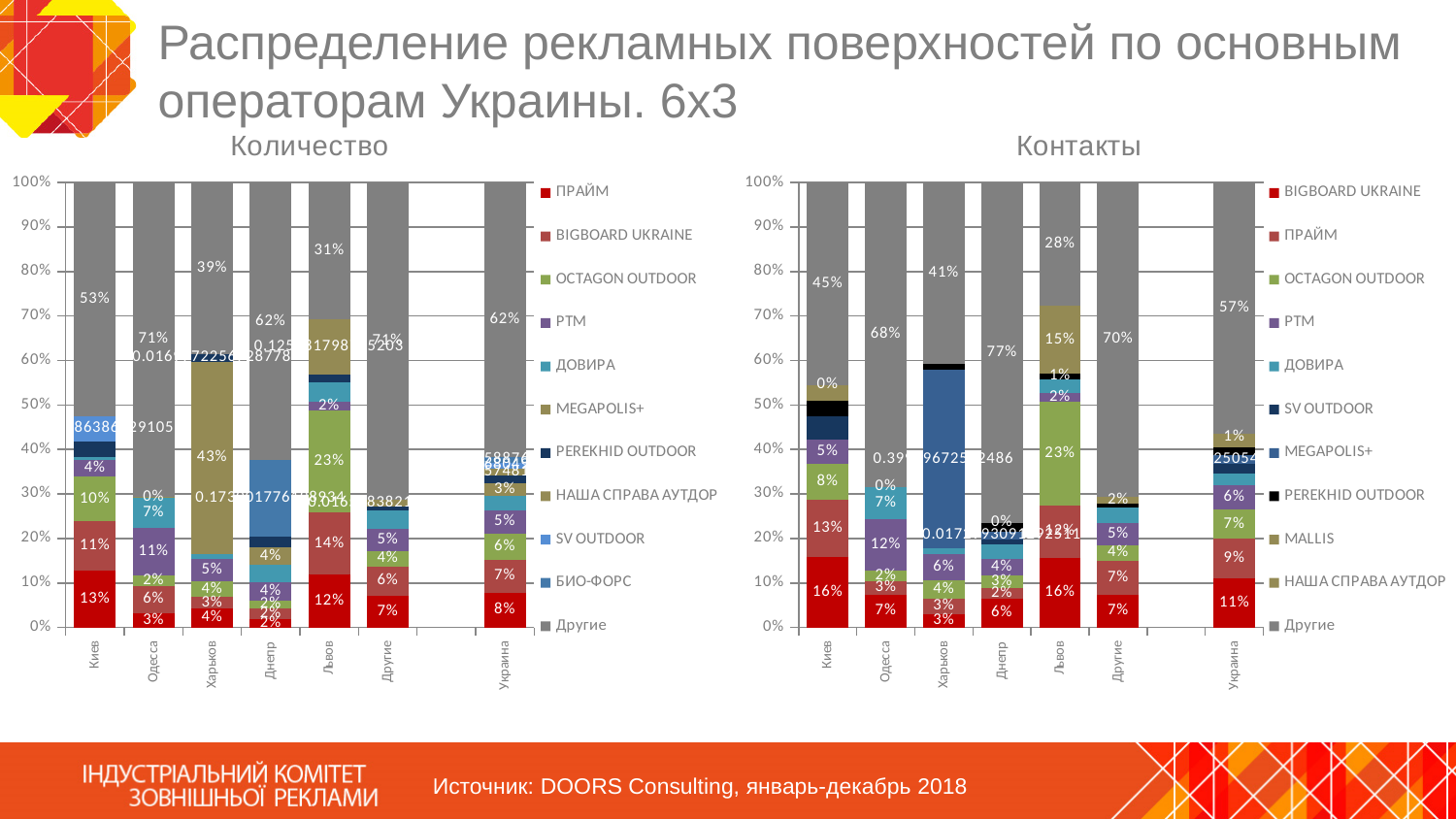
In the "Количество" chart, what is the value for ПРАЙМ in Киев? 13% How many categories are shown on the x axis of the "Количество" chart? 7 In the "Контакты" chart, which city has the lowest value for Другие? Львов In the "Контакты" chart, what is the value for BIGBOARD UKRAINE in Киев? 16% How many series does the legend of the "Контакты" chart list? 11 In the "Количество" chart, what is the value for MEGAPOLIS+ in Харьков? 43% In the "Контакты" chart, which is larger: the Другие value for Одесса or for Харьков? Одесса In the "Количество" chart, what is the difference between the Другие value for Одесса and for Львов? 40% In the "Контакты" chart, what is the value for Другие in Днепр? 77% In the "Контакты" chart, what is the value for OCTAGON OUTDOOR in Львов? 23% In the "Количество" chart, what is the value for Другие in Харьков? 39% In the "Количество" chart, what is the value for Другие in Украина? 62%